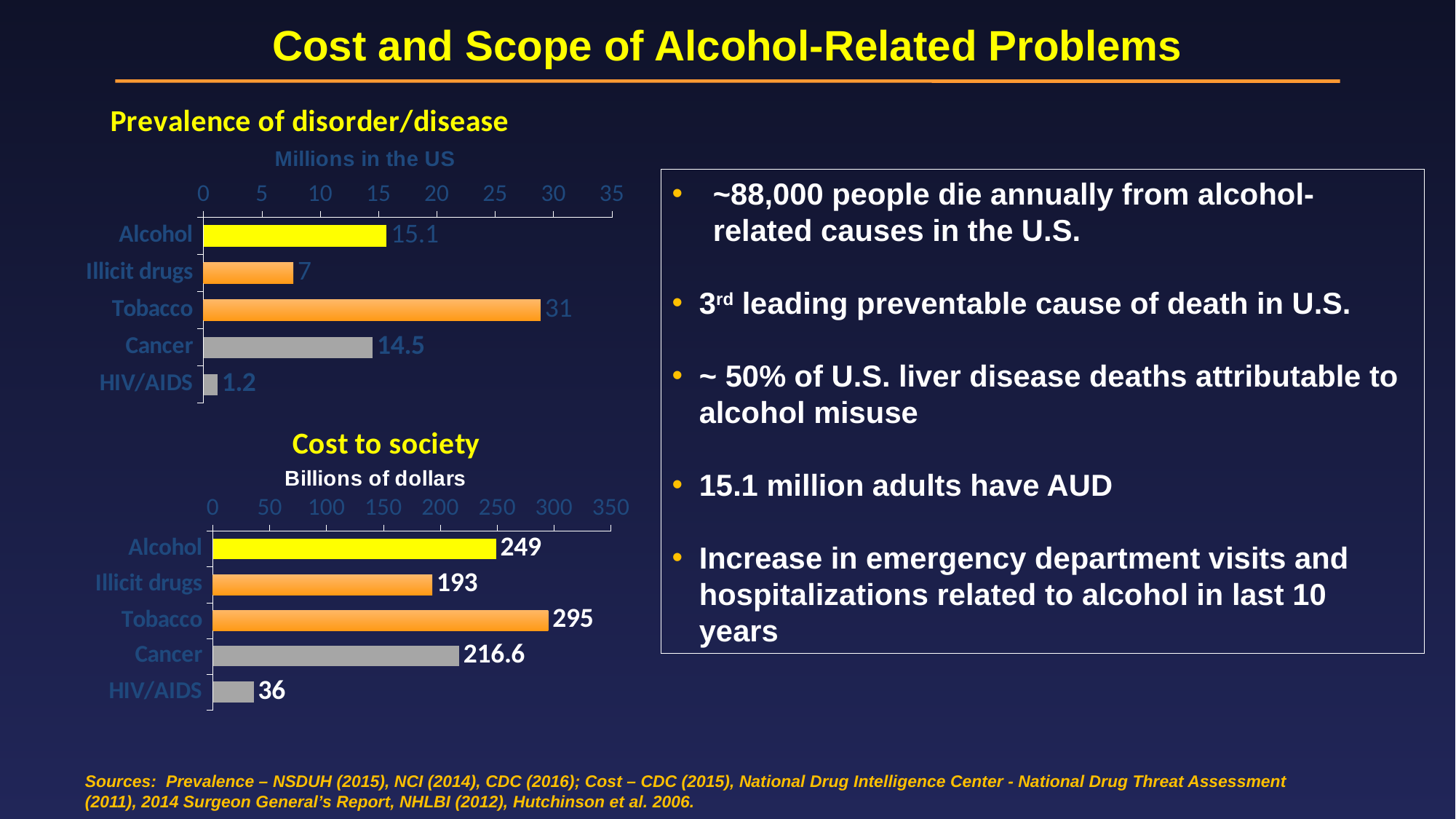
In the 'Cost to society' chart, what is the difference between the values for Tobacco and Alcohol? 46 In the 'Prevalence of disorder/disease' chart, which category has the lowest value? HIV/AIDS What kind of chart is the 'Prevalence of disorder/disease' chart? Bar chart In the 'Prevalence of disorder/disease' chart, what is the difference between the values for Alcohol and Cancer? 0.6 In the 'Cost to society' chart, which category has the highest value? Tobacco In the 'Prevalence of disorder/disease' chart, which category has the highest value? Tobacco In the 'Prevalence of disorder/disease' chart, what is the value for Alcohol? 15.1 In the 'Cost to society' chart, what is the value for Cancer? 216.6 In the 'Prevalence of disorder/disease' chart, what is the value for Tobacco? 31 In the 'Cost to society' chart, what is the value for HIV/AIDS? 36 How many categories are shown in the 'Cost to society' chart? 5 In the 'Cost to society' chart, which is larger, the value for Alcohol or the value for Illicit drugs? Alcohol